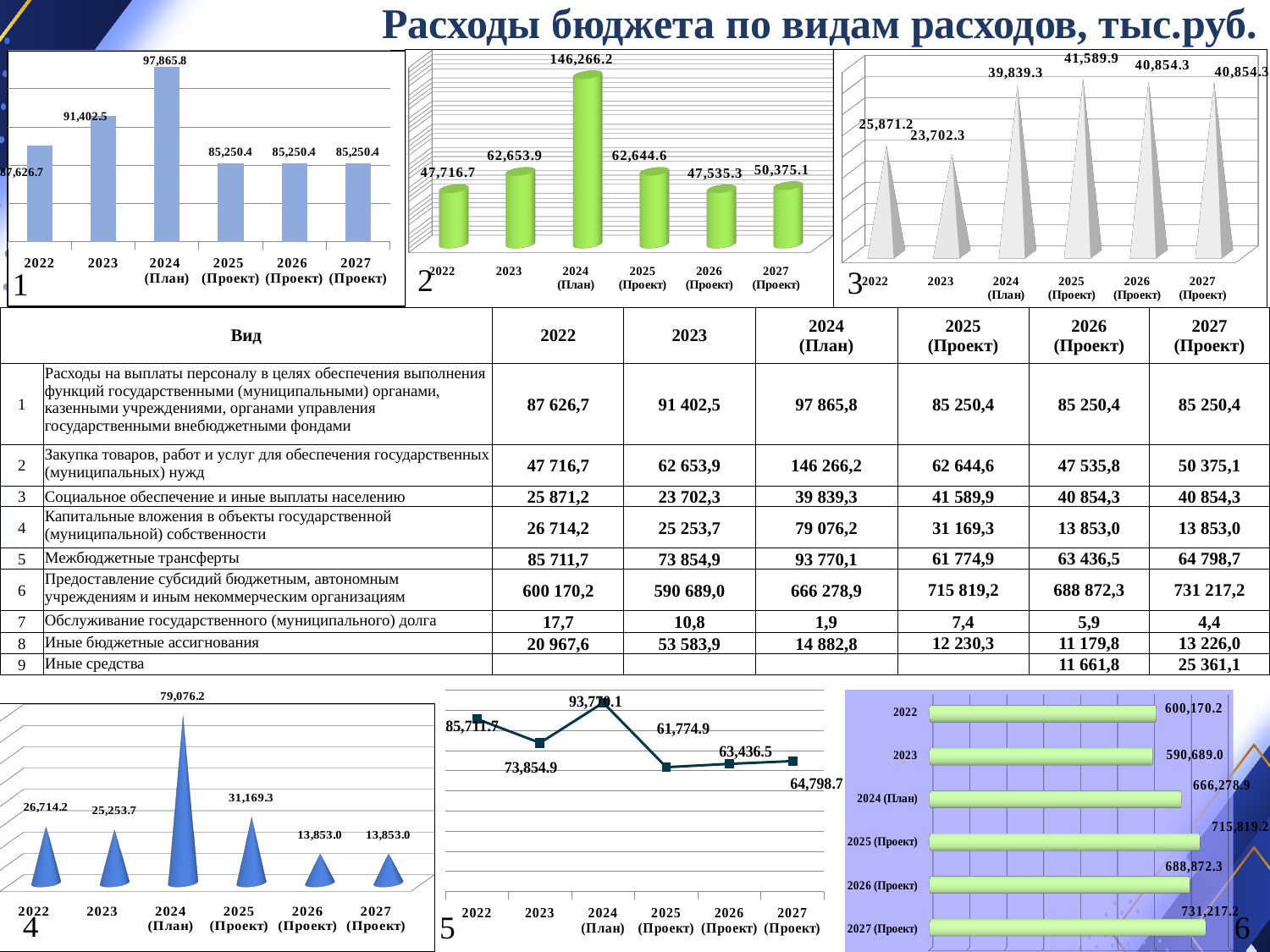
In chart 3 (top-right, grey cones), what is the difference between the 2022 and 2023 values? 2,168.9 In chart 1 (top-left, blue bars), what is the value for 2024 (План)? 97,865.8 What kind of chart is chart 5 (bottom-middle)? Line chart In chart 1 (top-left, blue bars), which year has the highest value? 2024 (План) In chart 6 (bottom-right, horizontal bars), which category has the highest value? 2027 (Проект) In chart 4 (bottom-left, blue cones), how many categories are shown on the x axis? 6 In chart 5 (bottom-middle, line chart), which is larger: the value for 2022 or the value for 2023? 2022 In chart 3 (top-right, grey cones), what is the value for 2025 (Проект)? 41,589.9 In chart 2 (top-middle, green cylinders), what is the value for 2024 (План)? 146,266.2 In chart 2 (top-middle, green cylinders), which year has the lowest value? 2026 (Проект) In chart 6 (bottom-right, horizontal bars), what is the value for 2027 (Проект)? 731,217.2 In chart 4 (bottom-left, blue cones), what is the value for 2024 (План)? 79,076.2